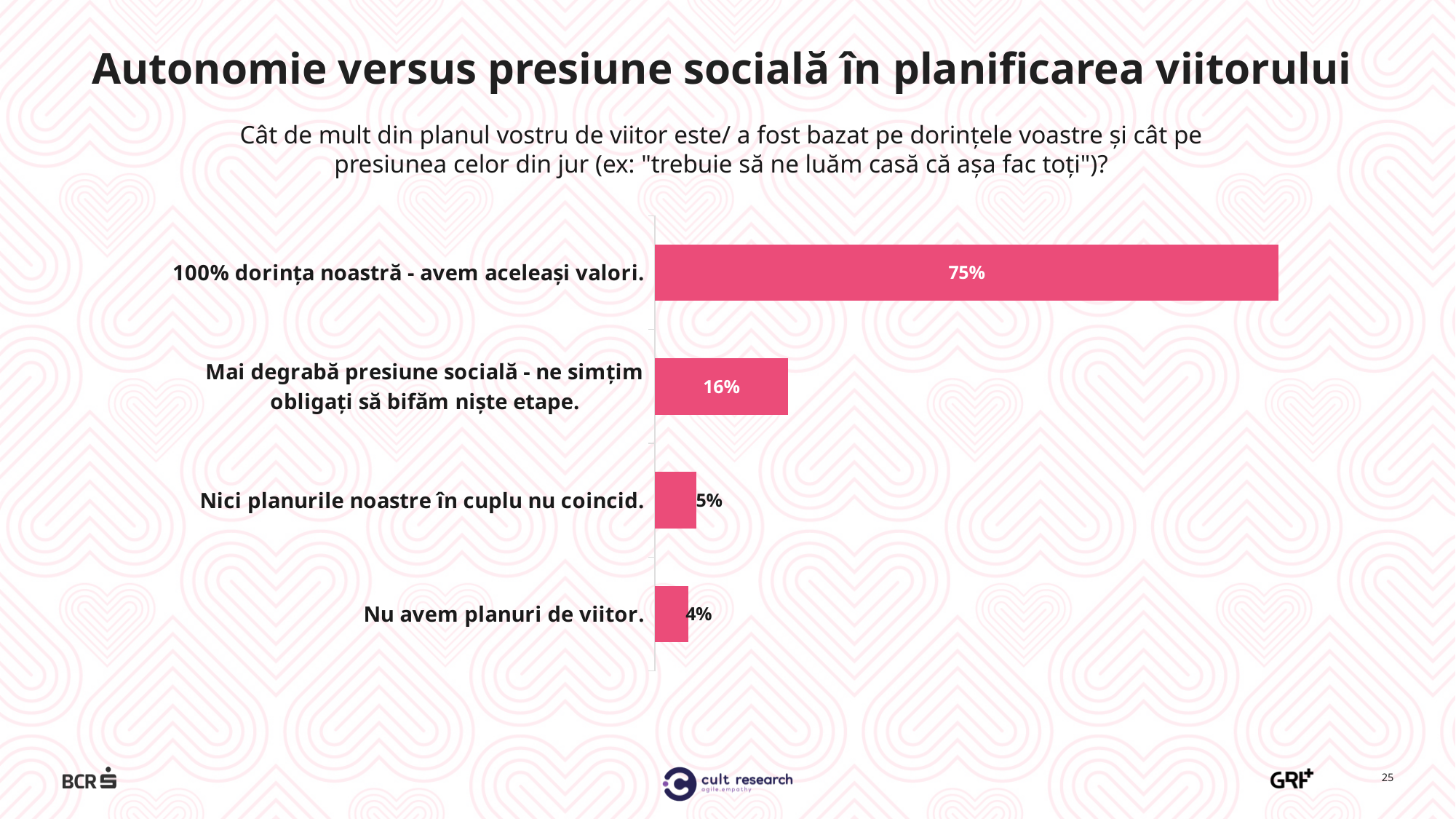
What is the title of the slide? Autonomie versus presiune socială în planificarea viitorului What percentage of respondents chose "100% dorința noastră - avem aceleași valori."? 75% Which category has the highest value? 100% dorința noastră - avem aceleași valori. What kind of chart is shown on the slide? Bar chart What is the value for "Mai degrabă presiune socială - ne simțim obligați să bifăm niște etape."? 16% Which category has the lowest value? Nu avem planuri de viitor. What is the difference between the values for "Mai degrabă presiune socială - ne simțim obligați să bifăm niște etape." and "Nici planurile noastre în cuplu nu coincid."? 11% What is the difference between the values for "100% dorința noastră - avem aceleași valori." and "Mai degrabă presiune socială - ne simțim obligați să bifăm niște etape."? 59% What is the value for "Nici planurile noastre în cuplu nu coincid."? 5% What is the value for "Nu avem planuri de viitor."? 4% How many categories are shown in the chart? 4 Which is larger: the value for "Mai degrabă presiune socială - ne simțim obligați să bifăm niște etape." or for "Nici planurile noastre în cuplu nu coincid."? Mai degrabă presiune socială - ne simțim obligați să bifăm niște etape.